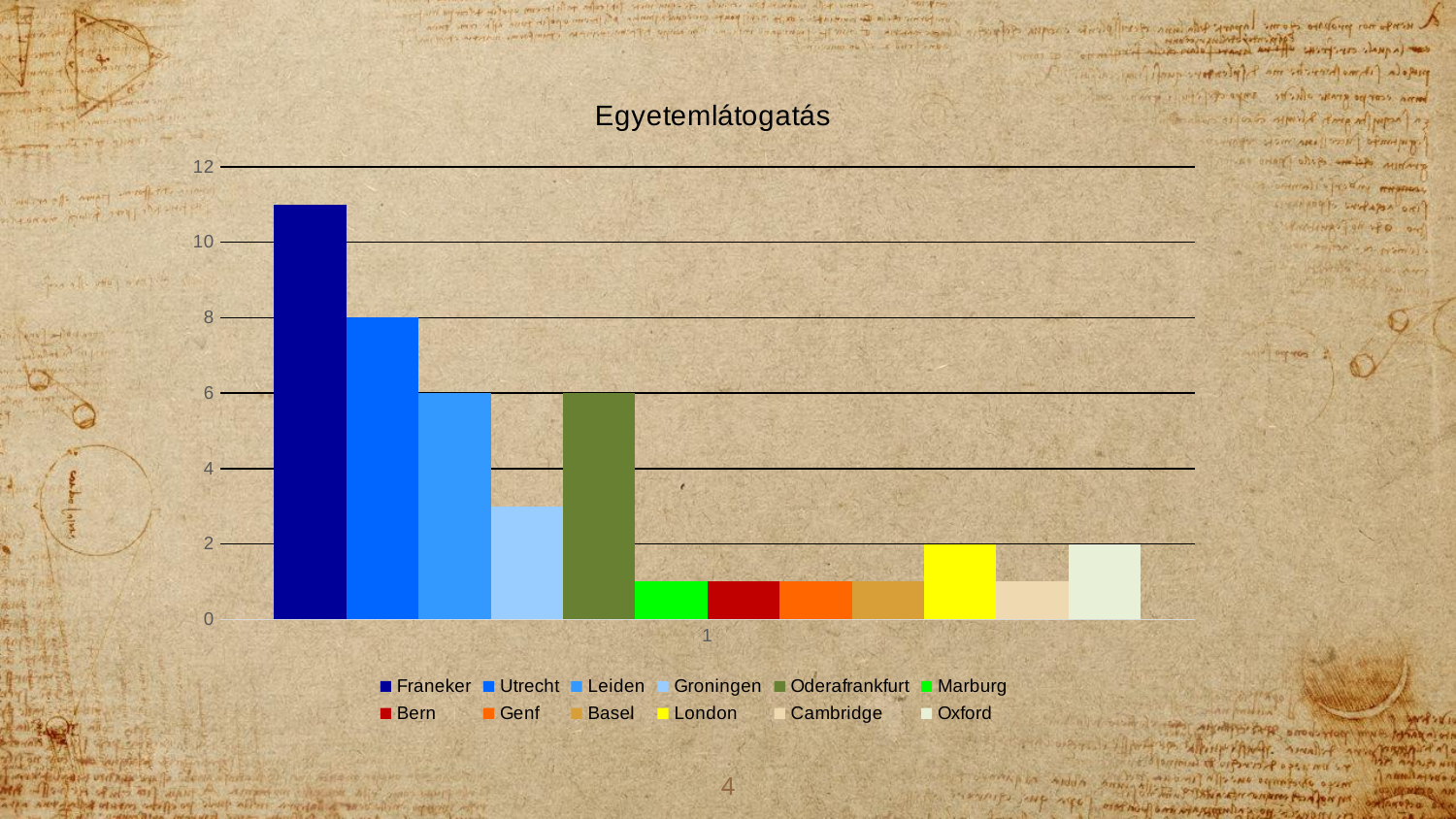
Which is larger, the value for Utrecht or the value for Leiden? Utrecht How many series does the legend list? 12 Which series has the highest bar? Franeker What is the value for London? 2 What is the value for Oderafrankfurt? 6 What is the value for Utrecht? 8 Is the value for Franeker greater or less than 10? greater What is the difference between the values for Utrecht and Leiden? 2 What is the title of the chart? Egyetemlátogatás Is the value for Groningen greater or less than 4? less What is the value for Leiden? 6 What kind of chart is shown on the slide? bar chart